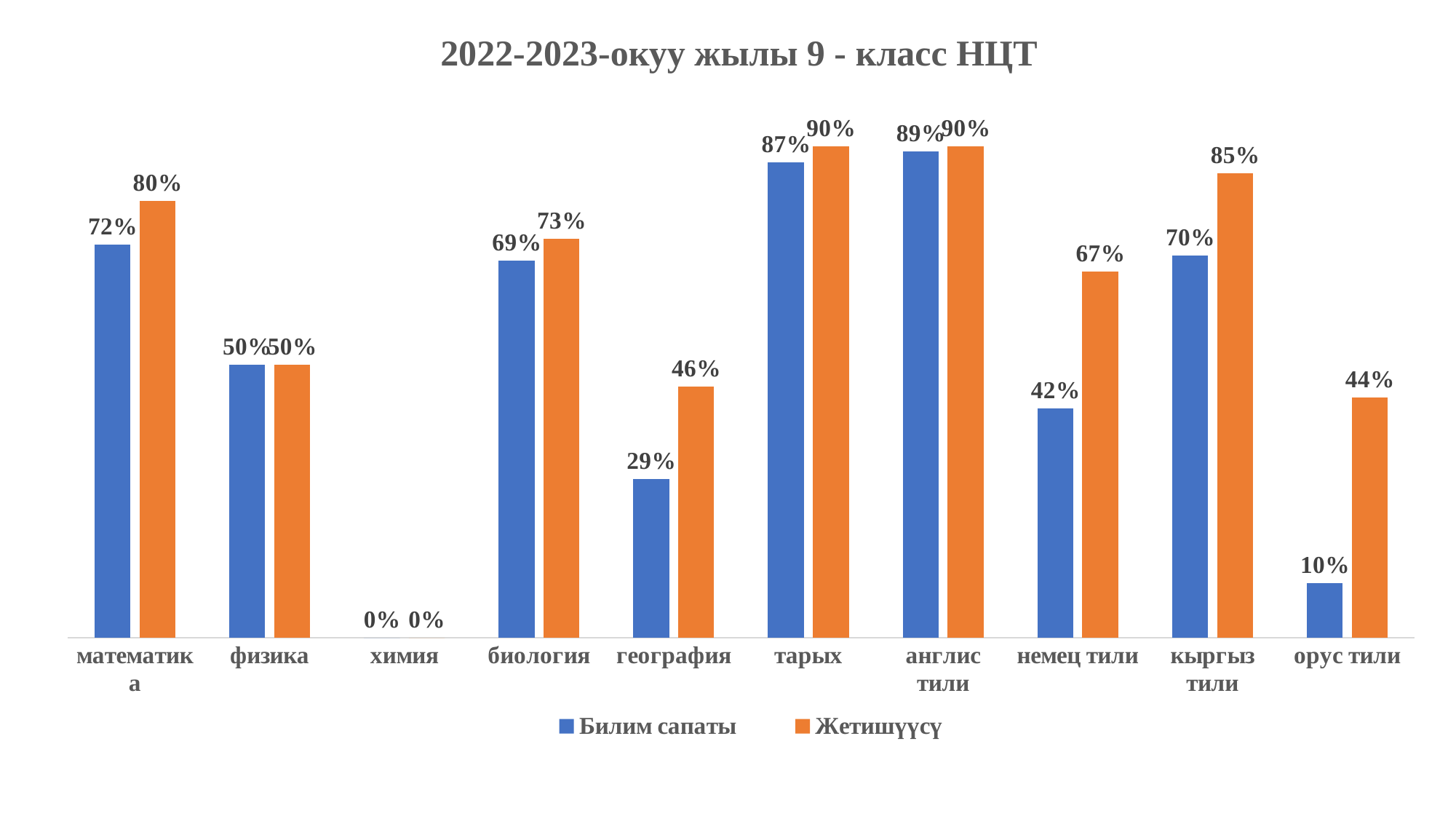
What is the difference between the Жетишүүсү and Билим сапаты values for немец тили? 25% What is the Билим сапаты value for география? 29% Which category has the lowest Жетишүүсү value? химия How many series does the legend list? 2 What is the difference between the Жетишүүсү values for математика and орус тили? 36% Which is larger, the Билим сапаты value for биология or for кыргыз тили? кыргыз тили What is the title of the chart? 2022-2023-окуу жылы 9 - класс НЦТ What is the Билим сапаты value for орус тили? 10% What kind of chart is shown on the slide? bar chart How many categories are shown on the x axis? 10 Which category has the highest Билим сапаты value? англис тили What is the Жетишүүсү value for кыргыз тили? 85%